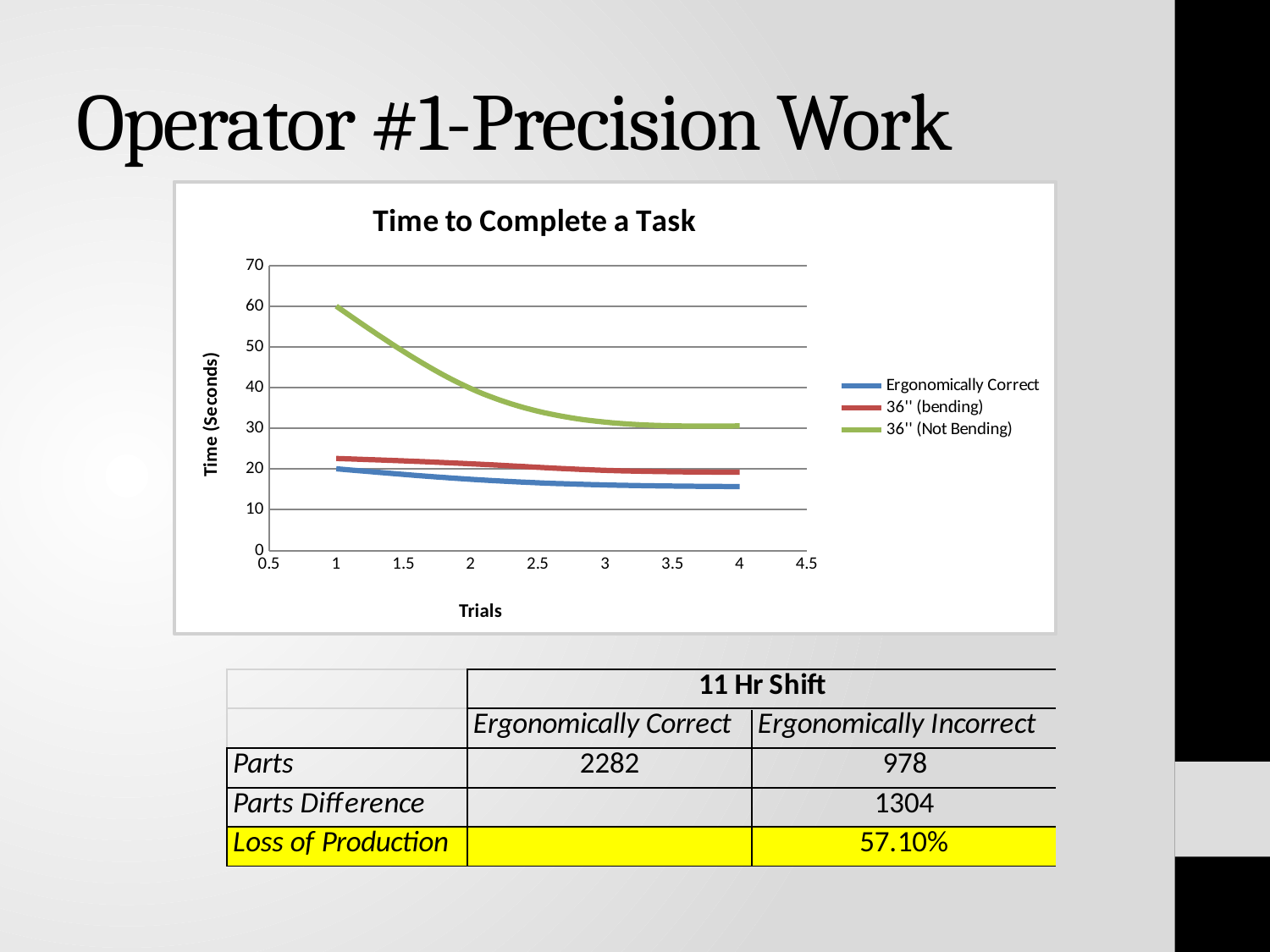
Which series has the lowest time at trial 4? Ergonomically Correct Is the value for 36'' (Not Bending) at trial 1 greater or less than 50? greater What kind of chart is shown on the slide? line chart Is the value for Ergonomically Correct at trial 4 greater or less than 20? less Does the Ergonomically Correct line rise or fall as the trials increase? fall Is the value for 36'' (bending) at trial 1 greater or less than 30? less Which series has the highest time at trial 1? 36'' (Not Bending) What is the title of the chart? Time to Complete a Task What is the label of the vertical axis of the chart? Time (Seconds) How many series does the legend of the chart list? 3 Does the 36'' (Not Bending) line rise or fall as the trials increase? fall